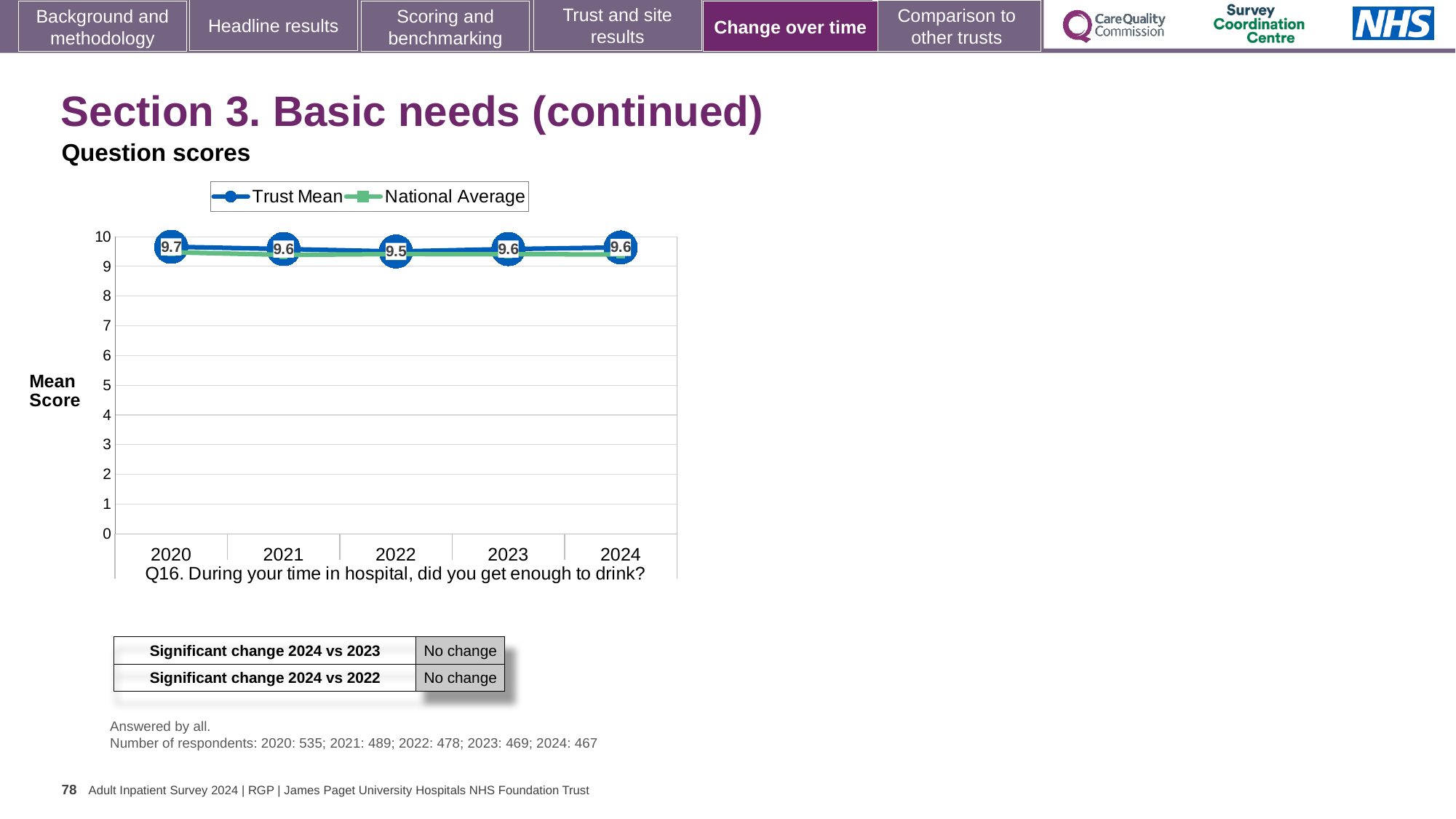
In which year is the Trust Mean score highest? 2020 What is the Trust Mean score for 2022? 9.5 What kind of chart is shown on the slide? Line chart What is the Trust Mean score for 2024? 9.6 How many series does the legend list? 2 Is the National Average value for 2024 greater or less than 9? greater What is the difference between the Trust Mean score in 2020 and in 2022? 0.2 How many years are plotted on the x axis? 5 Does the Trust Mean score rise or fall from 2020 to 2022? Fall Which is larger, the Trust Mean score in 2020 or in 2022? 2020 In which year is the Trust Mean score lowest? 2022 What is the Trust Mean score for 2020? 9.7